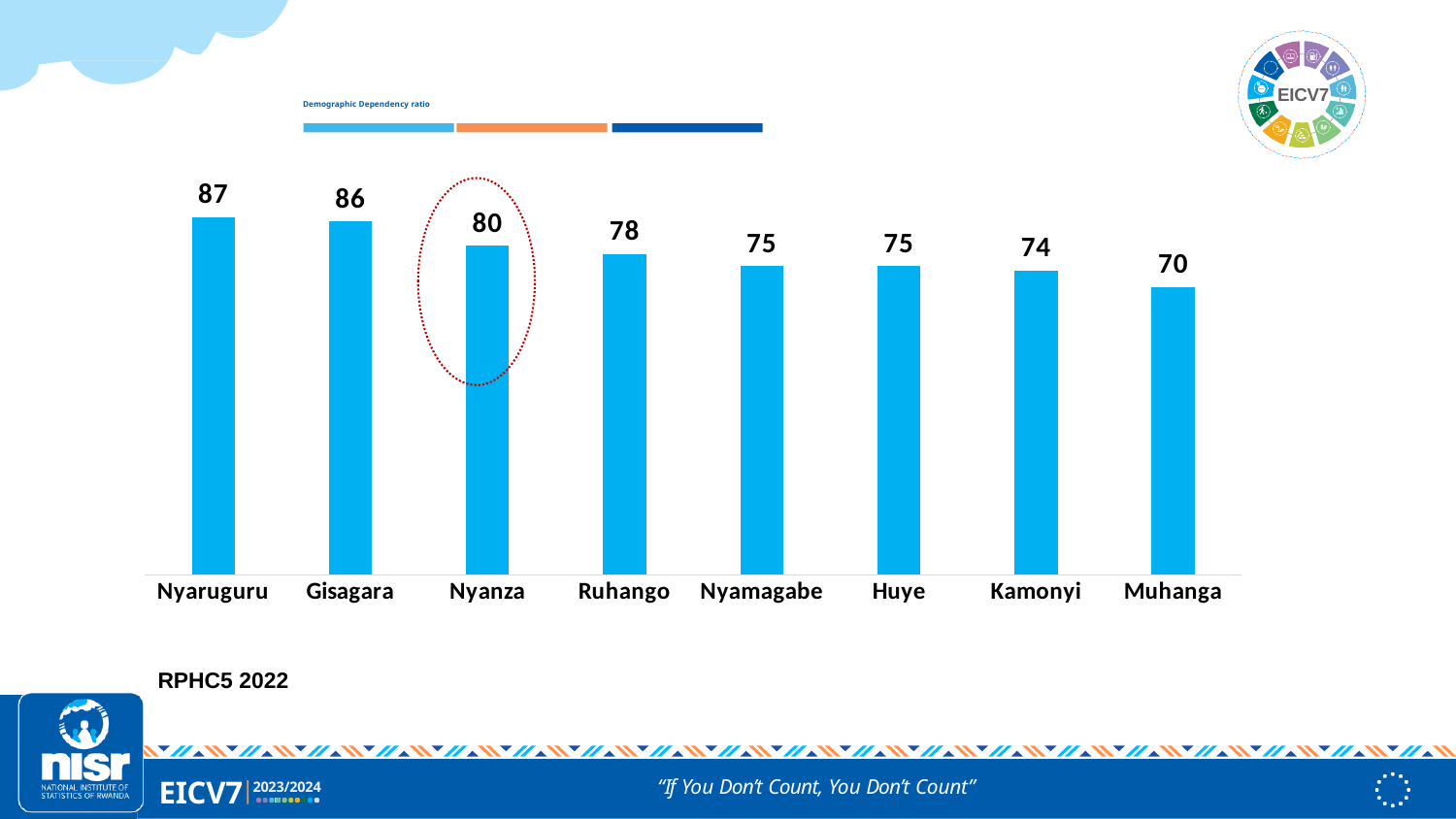
Which district has the highest demographic dependency ratio? Nyaruguru What is the difference between the demographic dependency ratios of Nyaruguru and Muhanga? 17 How many districts are shown in the chart? 8 Which district's bar is highlighted with a red dotted circle? Nyanza What is the demographic dependency ratio for Kamonyi? 74 Which district has a higher demographic dependency ratio, Ruhango or Kamonyi? Ruhango What is the demographic dependency ratio for Ruhango? 78 Which district has the lowest demographic dependency ratio? Muhanga What is the demographic dependency ratio for Nyanza? 80 What type of chart is shown on the slide? Bar chart What is the difference between the demographic dependency ratios of Gisagara and Nyanza? 6 What is the demographic dependency ratio for Nyaruguru? 87